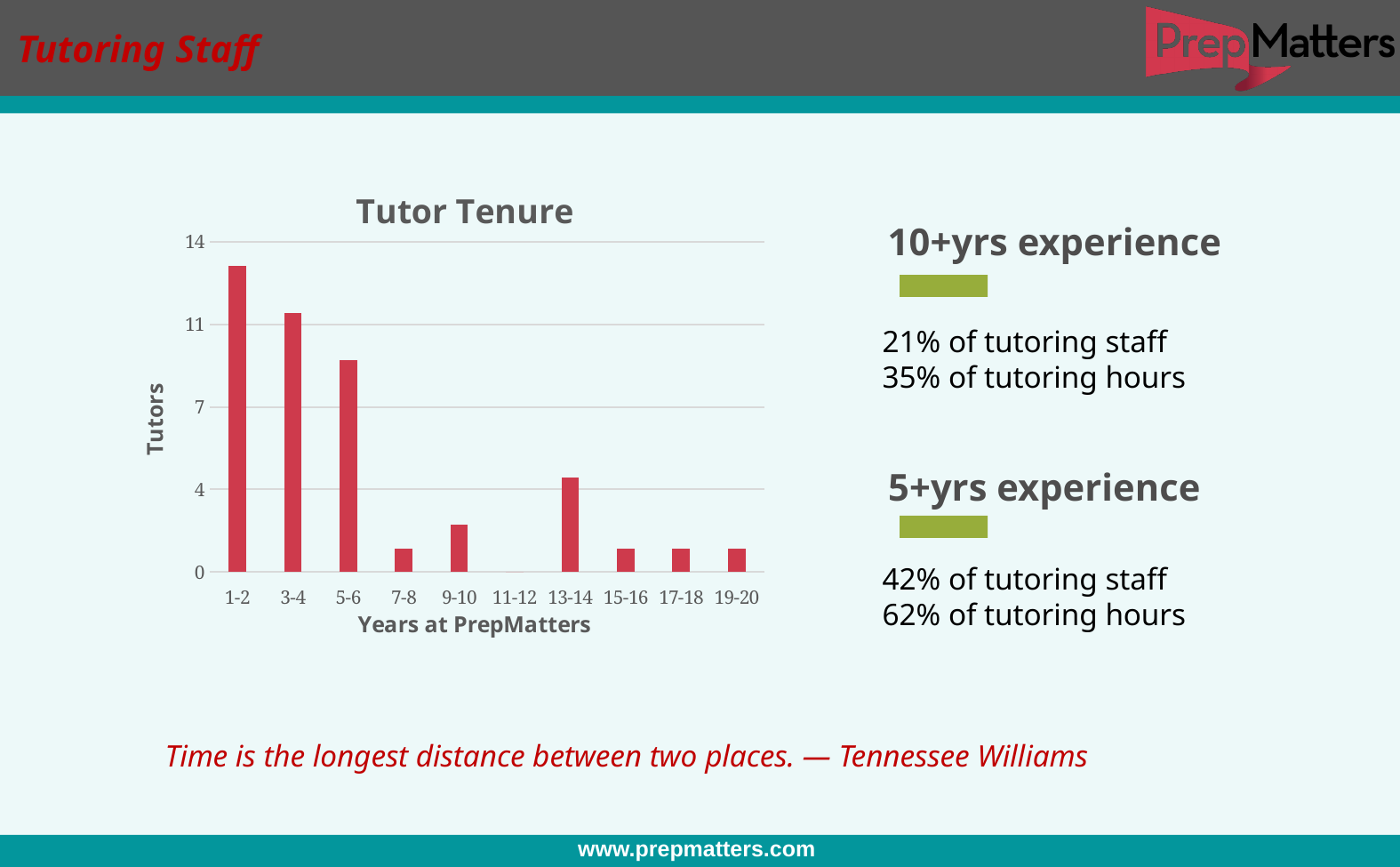
In the Tutor Tenure chart, is the value for 7-8 years greater or less than 4? less What kind of chart is the Tutor Tenure chart? bar chart In the Tutor Tenure chart, is the value for 5-6 years greater or less than 7? greater How many tenure categories are shown on the x axis of the Tutor Tenure chart? 10 In the Tutor Tenure chart, is the value for 13-14 years greater or less than 7? less Which tenure category in the Tutor Tenure chart has no bar at all (zero tutors)? 11-12 In the Tutor Tenure chart, which has more tutors: 3-4 years or 5-6 years? 3-4 What is the label of the x axis in the Tutor Tenure chart? Years at PrepMatters In the Tutor Tenure chart, which has more tutors: 9-10 years or 7-8 years? 9-10 In the Tutor Tenure chart, do the number of tutors generally rise or fall as years at PrepMatters increase from 1-2 to 7-8? fall Which tenure category has the highest number of tutors in the Tutor Tenure chart? 1-2